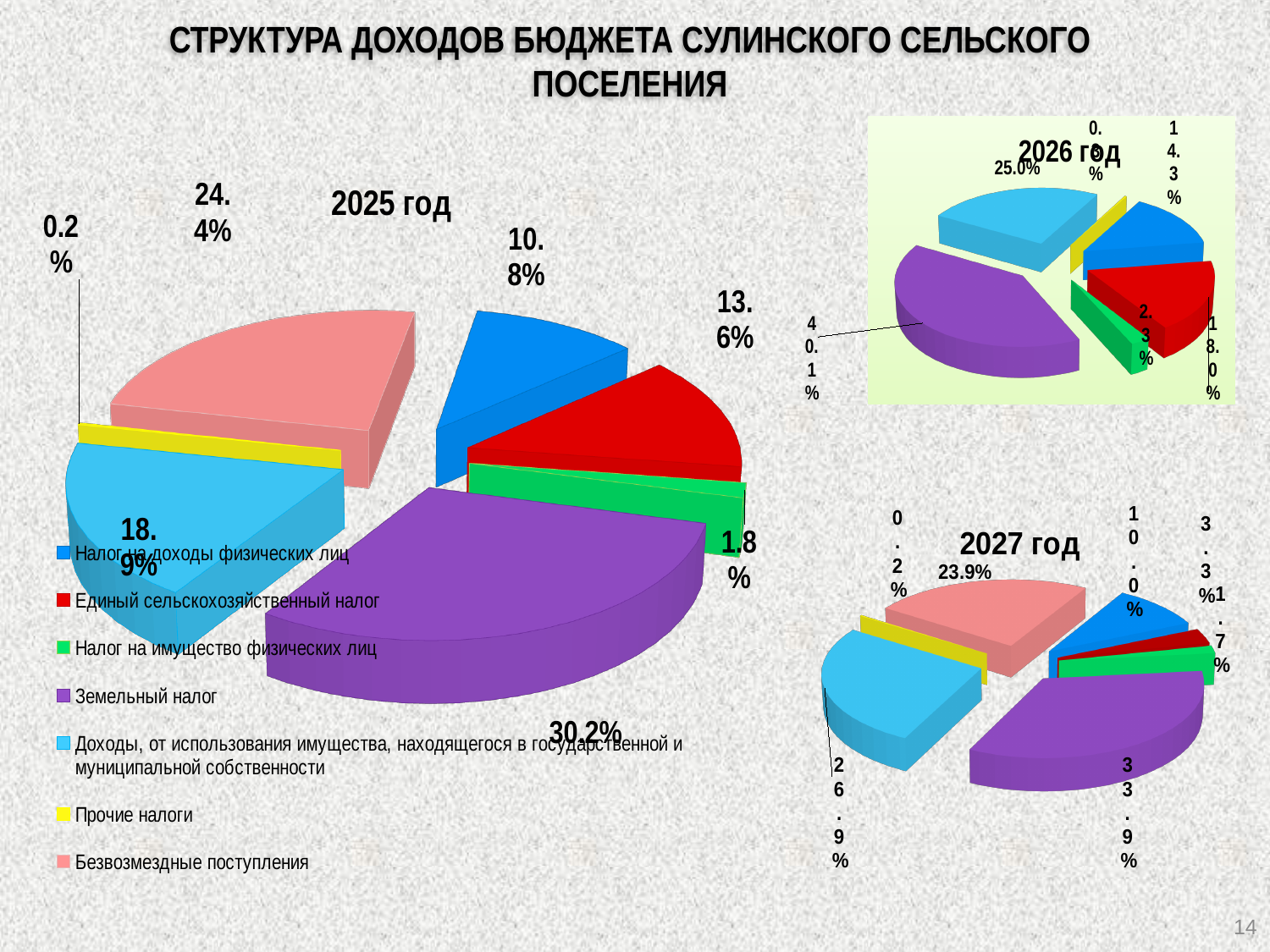
In the 2025 год chart, what share does Земельный налог have? 30.2% In the 2025 год chart, what share does Безвозмездные поступления have? 24.4% In the 2025 год chart, what share does Единый сельскохозяйственный налог have? 13.6% In the 2025 год chart, what is the difference between the shares of Земельный налог and Безвозмездные поступления? 5.8% In the 2026 год chart, what share does Земельный налог have? 40.1% What type of chart is used for the 2025 год chart? pie chart In the 2025 год chart, which category has the smallest share? Прочие налоги In the 2027 год chart, which is larger: the share of Земельный налог or the share of Налог на доходы физических лиц? Земельный налог In the 2026 год chart, what share does Доходы, от использования имущества, находящегося в государственной и муниципальной собственности have? 25.0% In the 2025 год chart, which category has the largest share? Земельный налог How many categories does the legend list? 7 In the 2027 год chart, what share does Безвозмездные поступления have? 23.9%